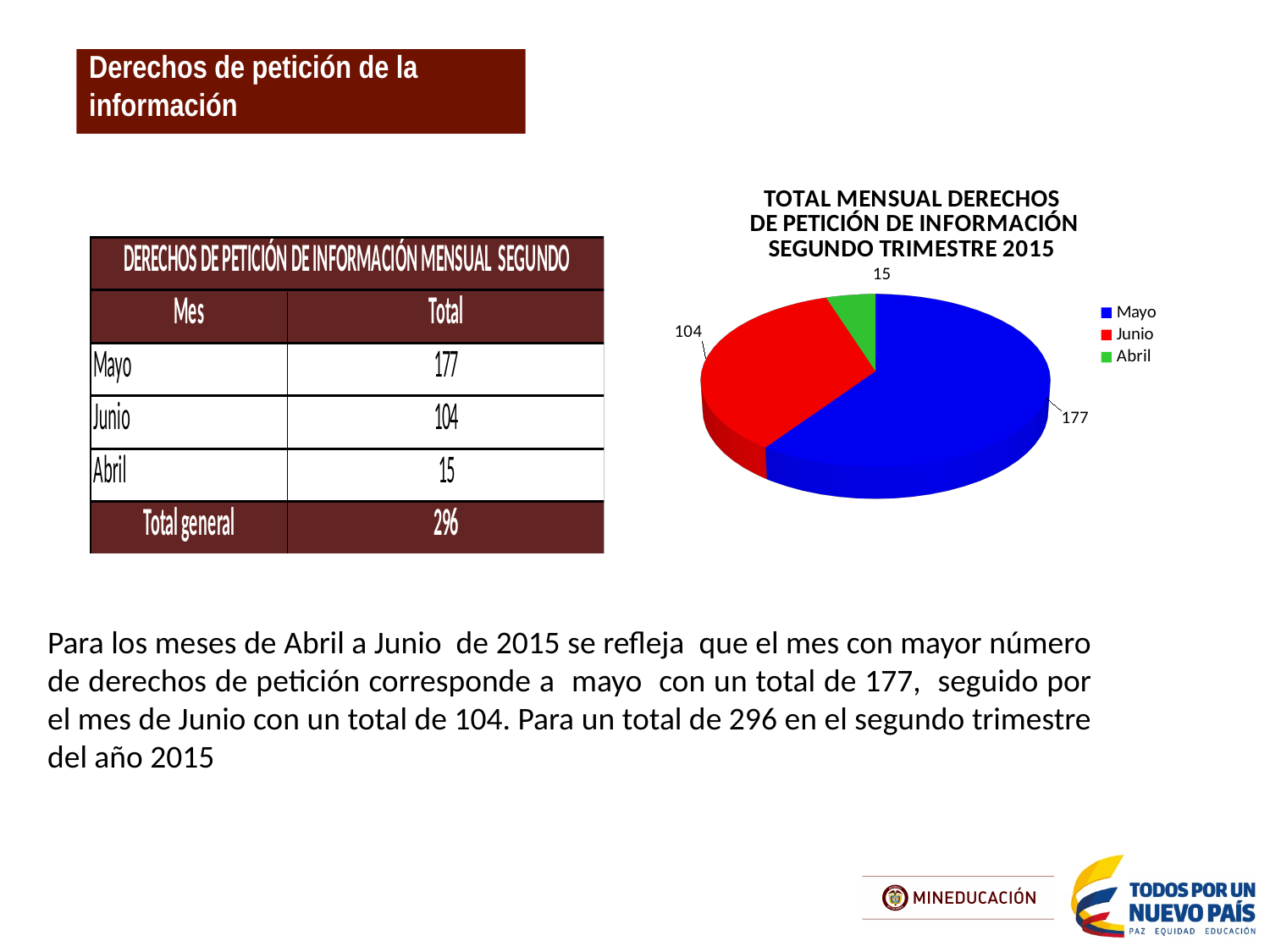
What type of chart is shown on the slide? Pie chart What is the value for Abril in the pie chart? 15 Which month has the smallest slice in the pie chart? Abril What is the value for Mayo in the pie chart? 177 What is the value for Junio in the pie chart? 104 What is the difference between the values for Junio and Abril? 89 What colour is the slice for Junio in the pie chart? Red How many slices does the pie chart have? 3 Which is larger, the value for Junio or the value for Abril? Junio What is the total of all the slices in the pie chart? 296 Which month has the largest slice in the pie chart? Mayo What is the difference between the values for Mayo and Junio? 73